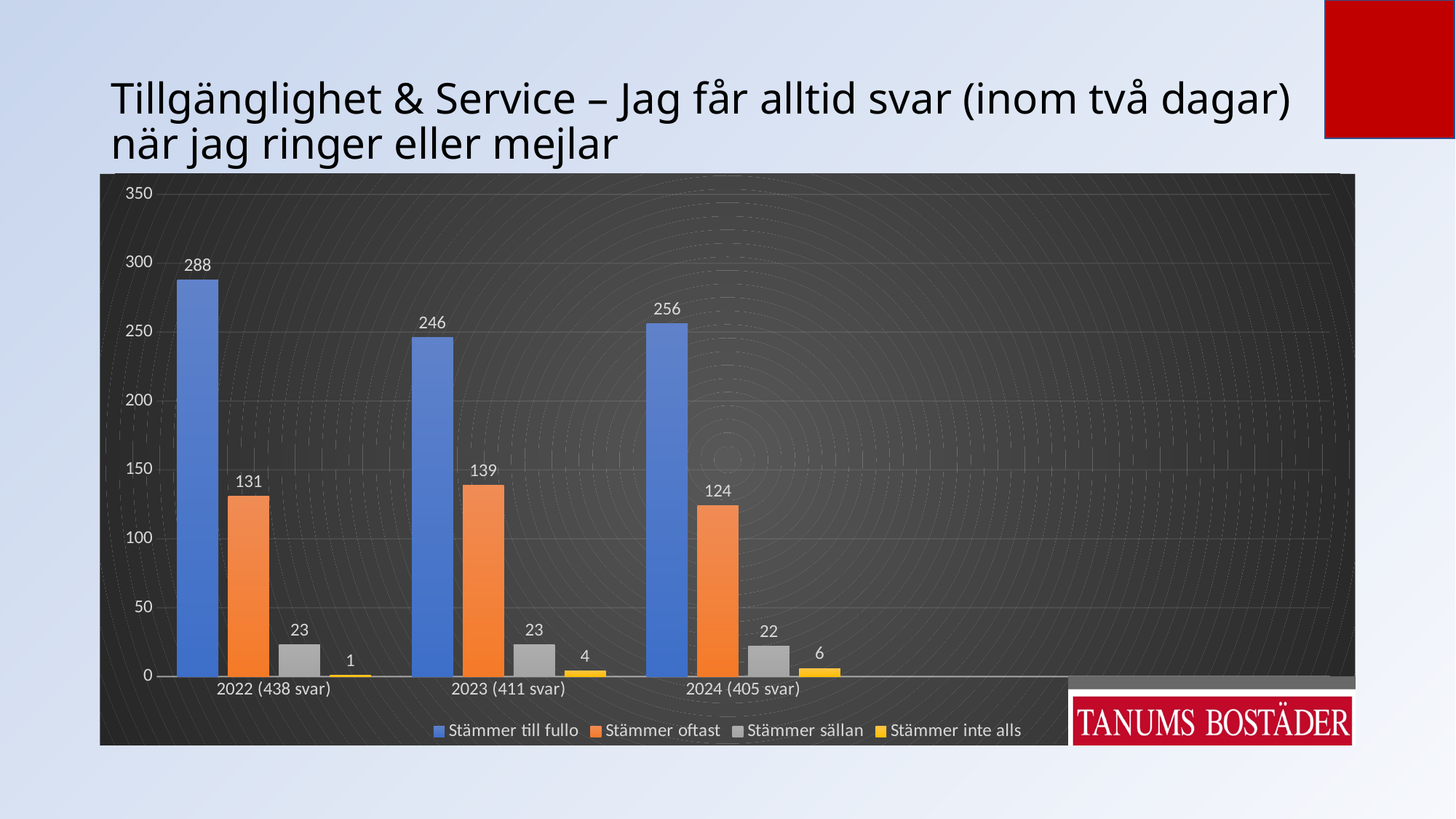
How many series does the legend list? 4 What is the value for "Stämmer inte alls" in 2024 (405 svar)? 6 What is the value for "Stämmer oftast" in 2023 (411 svar)? 139 How many year categories are shown on the x axis? 3 In which year is the value for "Stämmer inte alls" lowest? 2022 (438 svar) What is the difference between "Stämmer till fullo" in 2022 (438 svar) and in 2024 (405 svar)? 32 What is the value for "Stämmer till fullo" in 2022 (438 svar)? 288 What is the value for "Stämmer sällan" in 2024 (405 svar)? 22 Which is larger: "Stämmer oftast" in 2022 (438 svar) or in 2023 (411 svar)? 2023 (411 svar) In which year is the value for "Stämmer till fullo" highest? 2022 (438 svar) Does the value for "Stämmer till fullo" rise or fall from 2023 (411 svar) to 2024 (405 svar)? Rise What kind of chart is shown on the slide? Bar chart